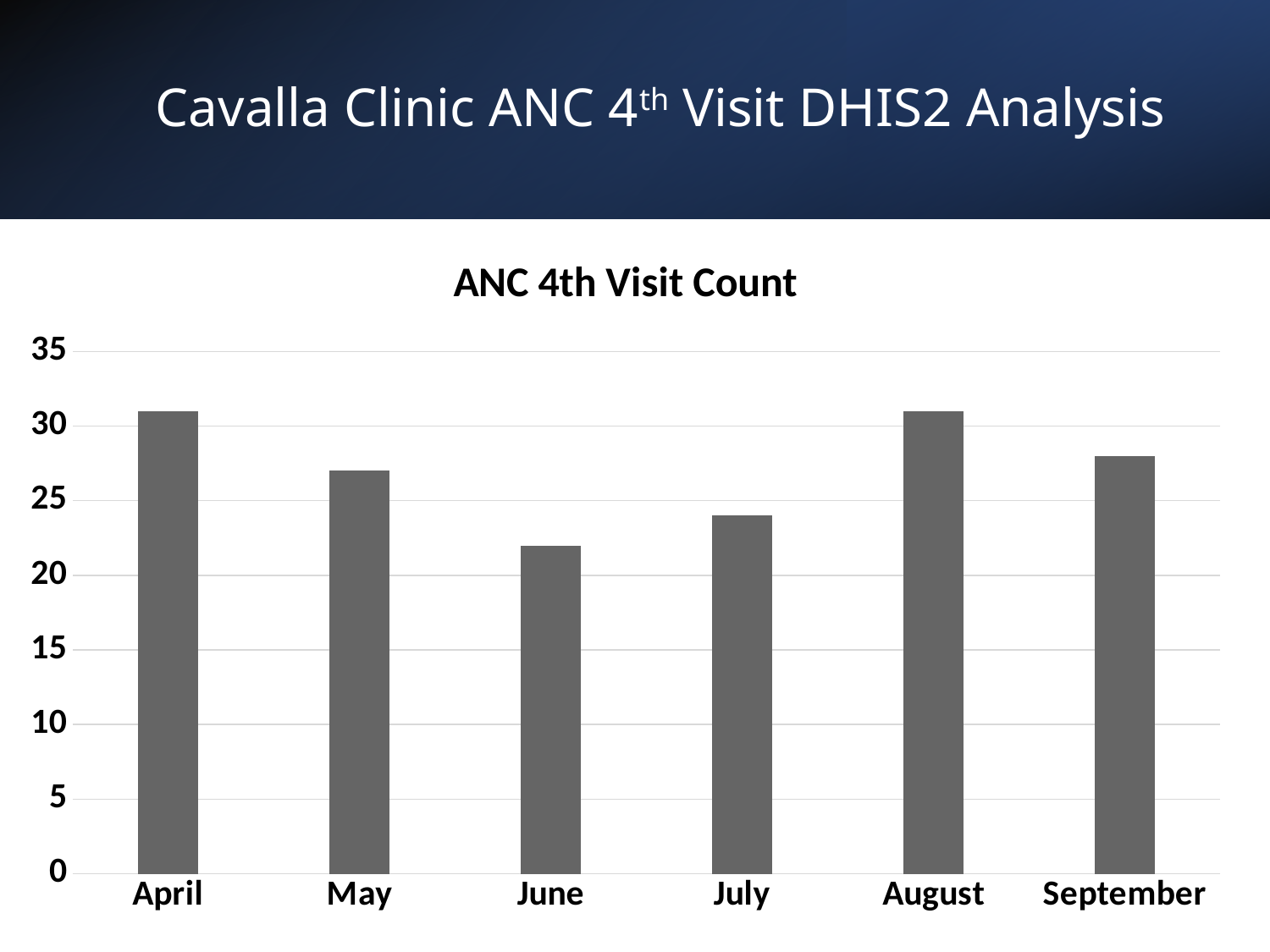
Which month has the lowest ANC 4th visit count? June Is the value for July greater or less than 25? less Is the value for September greater or less than 25? greater What is the title of the chart? ANC 4th Visit Count How many months are shown on the x axis of the chart? 6 Is the value for April greater or less than 30? greater Which is larger, the value for May or the value for June? May Do the values rise or fall from April to June? fall What kind of chart is shown on the slide? bar chart Which is larger, the value for July or the value for September? September